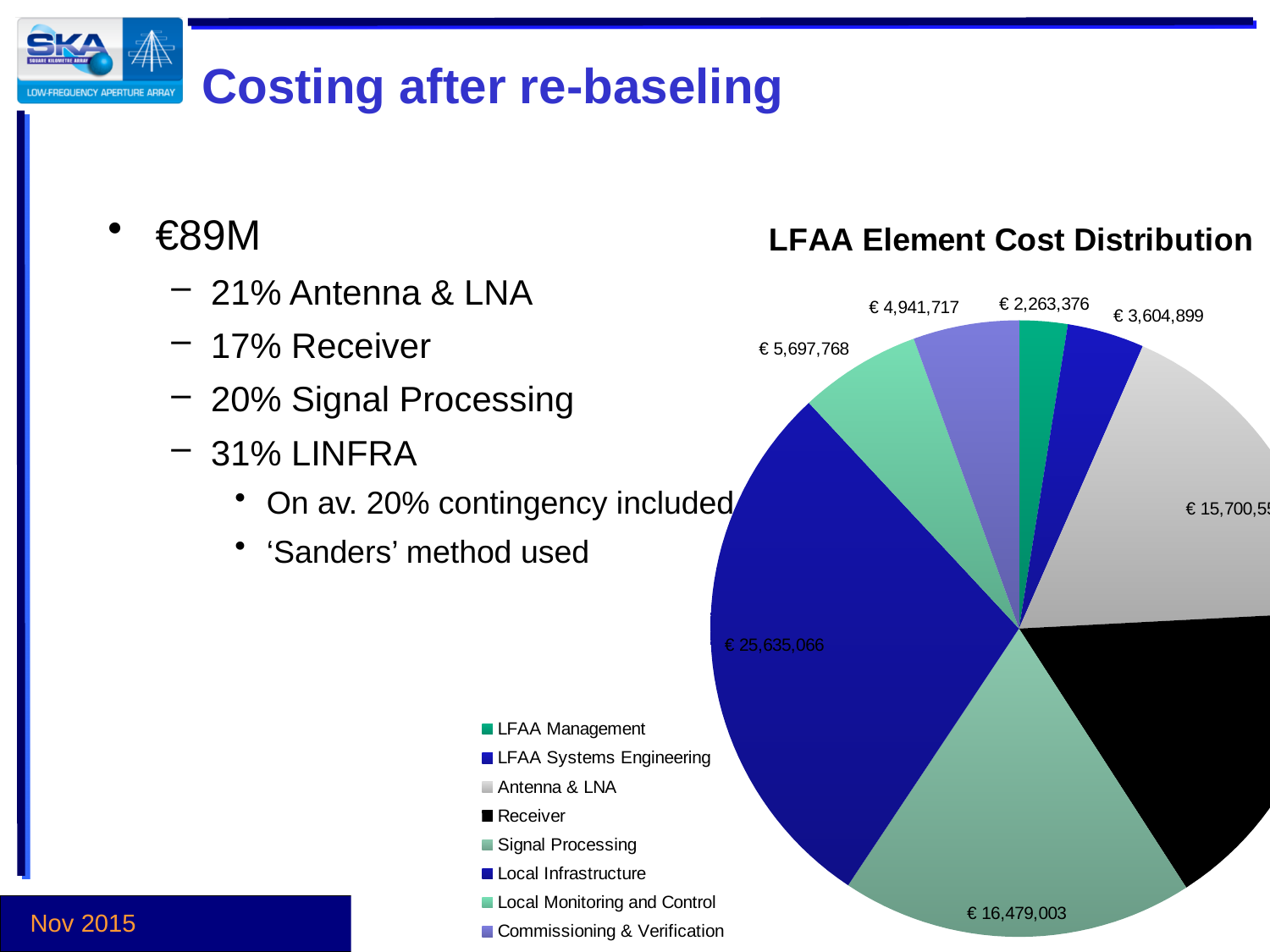
What is the value shown for LFAA Management? € 2,263,376 What is the value shown for Local Infrastructure? € 25,635,066 What is the difference between the values for Local Infrastructure and Signal Processing? € 9,156,063 What is the value shown for Local Monitoring and Control? € 5,697,768 What is the title of the chart? LFAA Element Cost Distribution What is the value shown for LFAA Systems Engineering? € 3,604,899 What kind of chart is shown on the slide? Pie chart Which category has the smallest slice of the pie? LFAA Management What is the value shown for Commissioning & Verification? € 4,941,717 What is the value shown for Signal Processing? € 16,479,003 How many entries does the chart's legend list? 8 Which category has the largest slice of the pie? Local Infrastructure